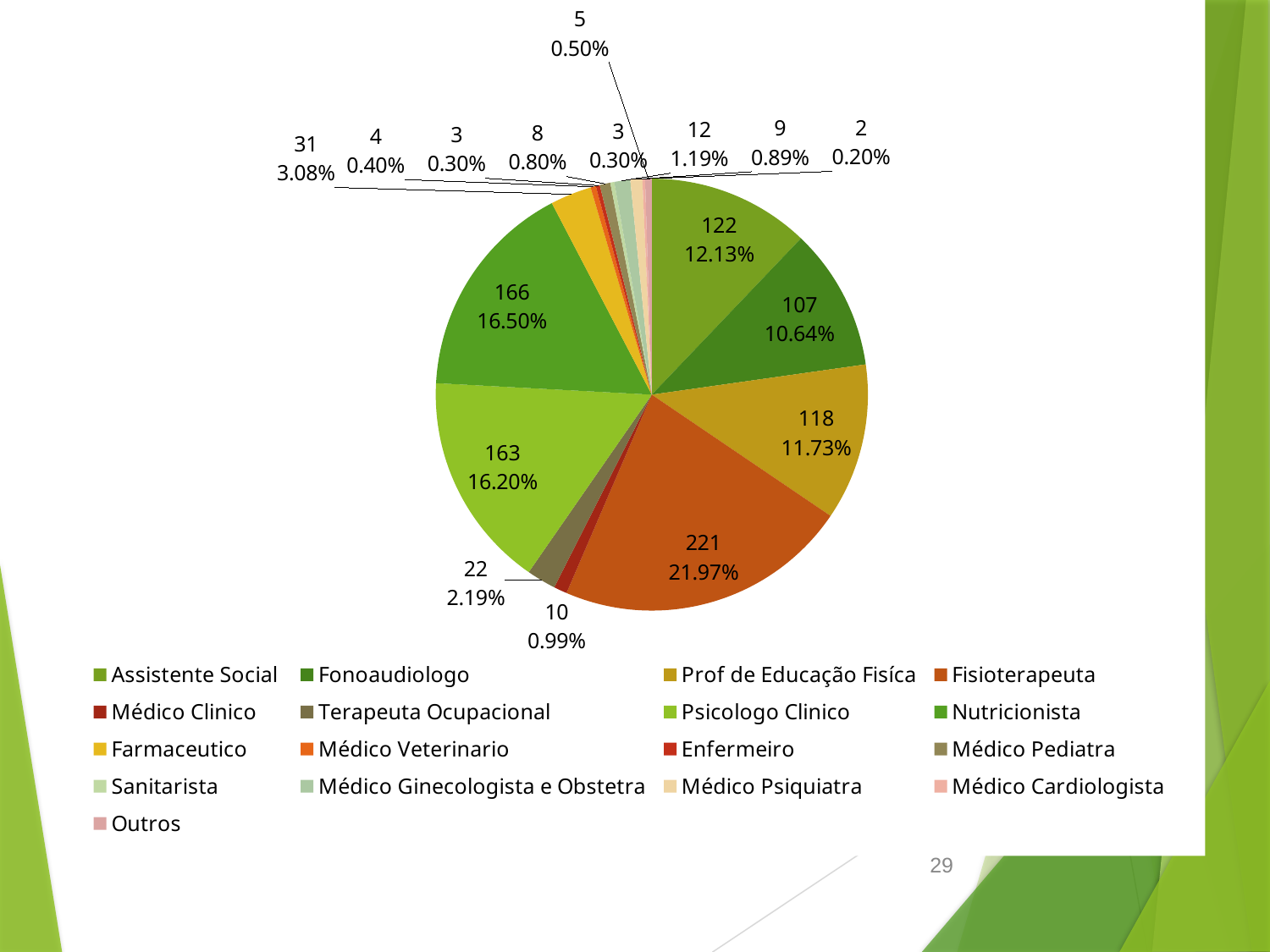
Which category has the largest slice of the pie chart? Fisioterapeuta What is the value shown for the Fisioterapeuta slice? 221 What kind of chart is shown on the slide? pie chart Which is larger, the Nutricionista slice or the Psicologo Clinico slice? Nutricionista What percentage share does the Fisioterapeuta slice have? 21.97% What percentage share does the Fonoaudiologo slice have? 10.64% What percentage share does the Psicologo Clinico slice have? 16.20% What is the value shown for the Terapeuta Ocupacional slice? 22 What is the value shown for the Assistente Social slice? 122 What is the difference between the Fisioterapeuta value and the Nutricionista value? 55 How many categories does the legend of the pie chart list? 17 What is the value shown for the Nutricionista slice? 166